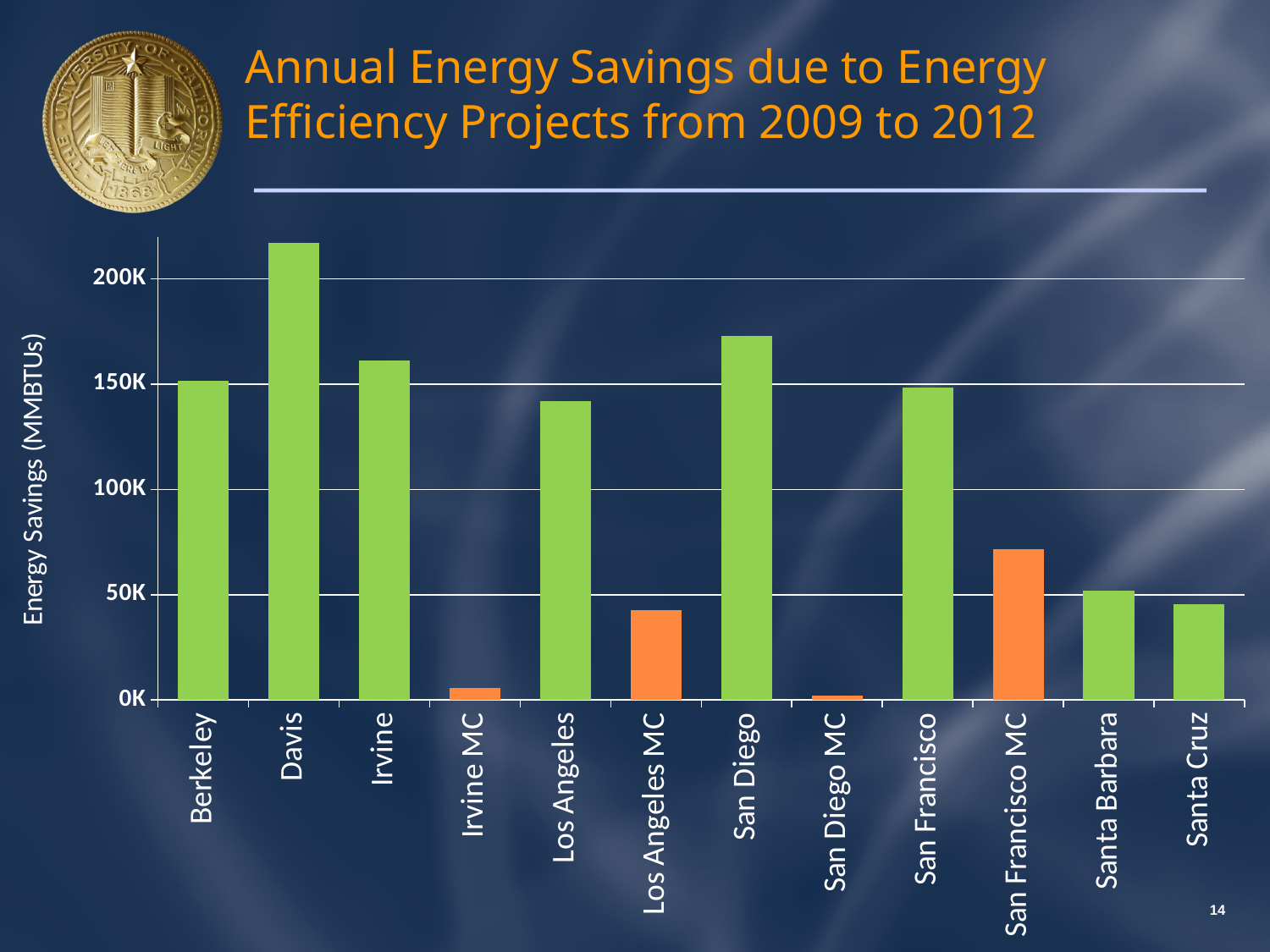
Is the value for Davis greater or less than 200K? greater Which has higher annual energy savings, San Diego or Irvine? San Diego Which category has the highest annual energy savings in the chart? Davis What kind of chart is shown on the slide? bar chart How many campuses or medical centers are shown on the x axis of the chart? 12 Which has higher annual energy savings, San Francisco MC or Los Angeles MC? San Francisco MC What is the label on the y axis of the chart? Energy Savings (MMBTUs) Is the value for San Diego greater or less than 150K? greater Is the value for Los Angeles greater or less than 150K? less Which category has the lowest annual energy savings in the chart? San Diego MC